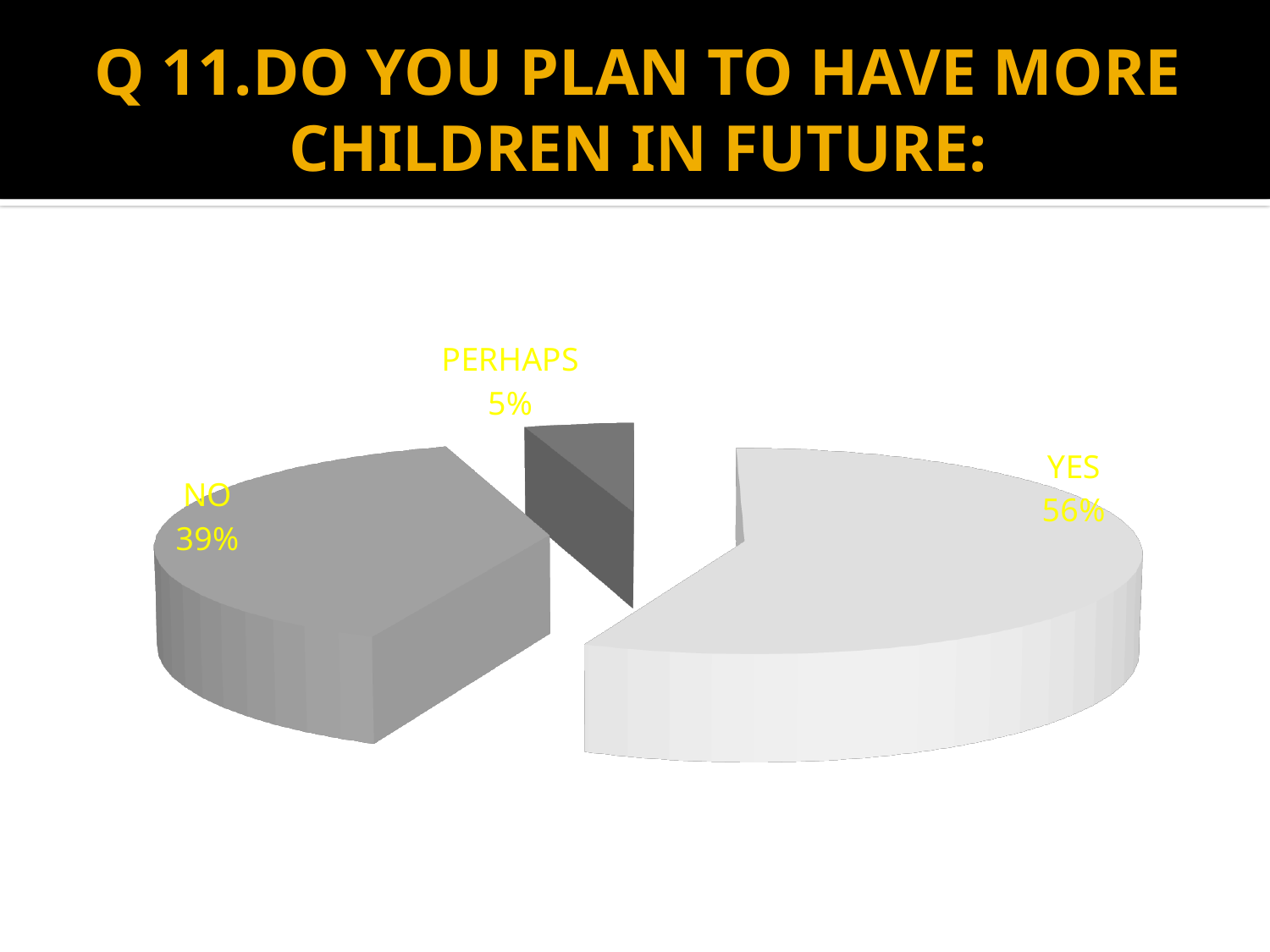
How many slices does the pie chart have? 3 What share of the pie does the YES slice represent? 56% What is the title of the slide? Q 11.DO YOU PLAN TO HAVE MORE CHILDREN IN FUTURE: What is the difference in percentage points between YES and NO? 17 What is the difference in percentage points between NO and PERHAPS? 34 What percentage of respondents answered YES? 56% Which response has the smallest share of the pie? PERHAPS Which is larger, the share for NO or the share for PERHAPS? NO What kind of chart is shown on the slide? Pie chart Which response has the largest share of the pie? YES What percentage of respondents answered NO? 39% What percentage of respondents answered PERHAPS? 5%